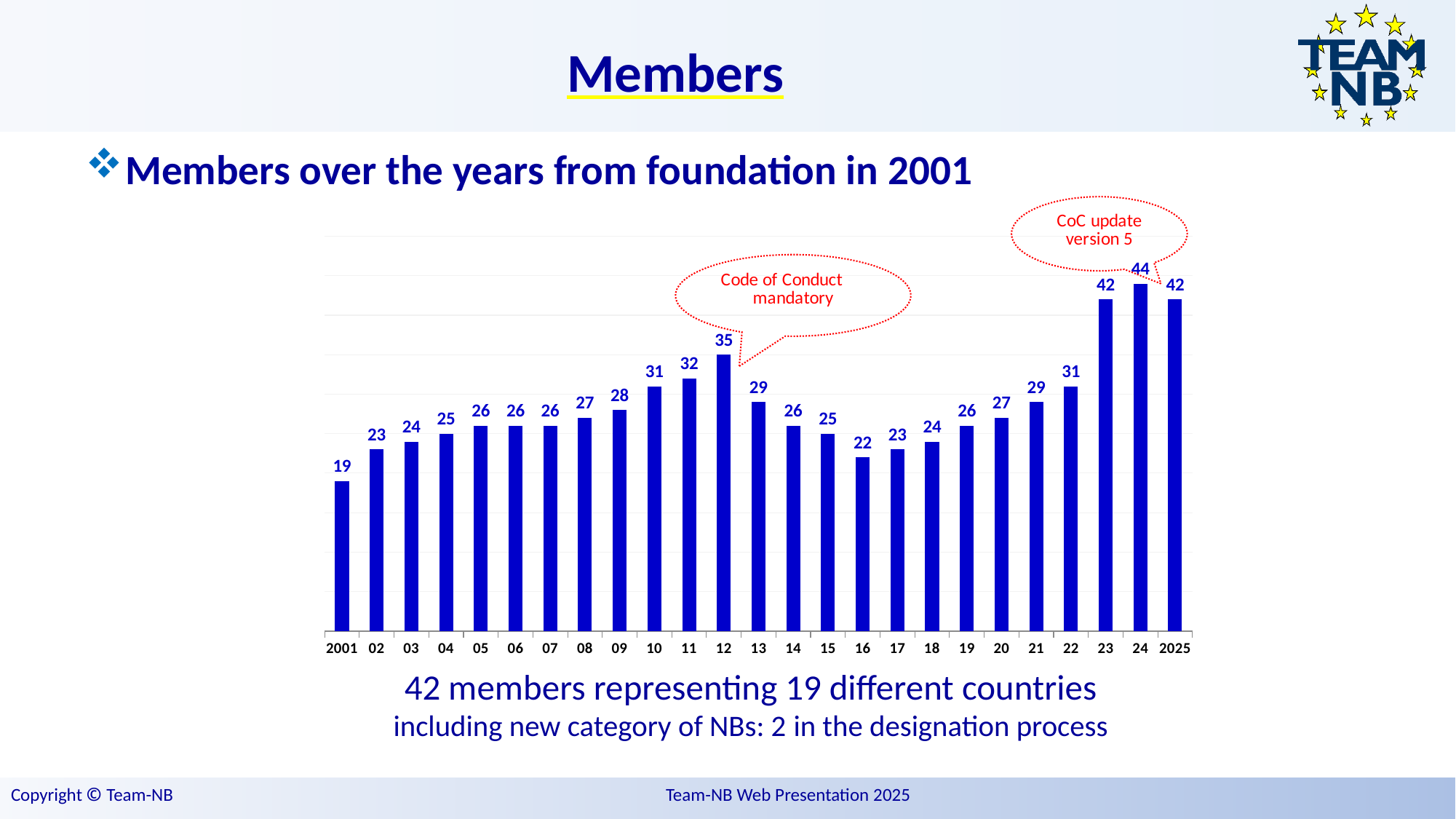
What is the difference in members between 2024 and 2023? 2 How many years (bars) are shown in the chart? 25 What is the difference in members between 2012 and 2013? 6 Which year had more members, 2011 or 2016? 2011 What was the number of members in 2012? 35 Did the number of members rise or fall from 2012 to 2016? Fall What was the number of members in 2001? 19 Which year has the lowest number of members? 2001 What was the number of members in 2025? 42 What does the callout above the 2012 bar say? Code of Conduct mandatory Which year has the highest number of members? 24 What kind of chart is shown on the slide? Bar chart